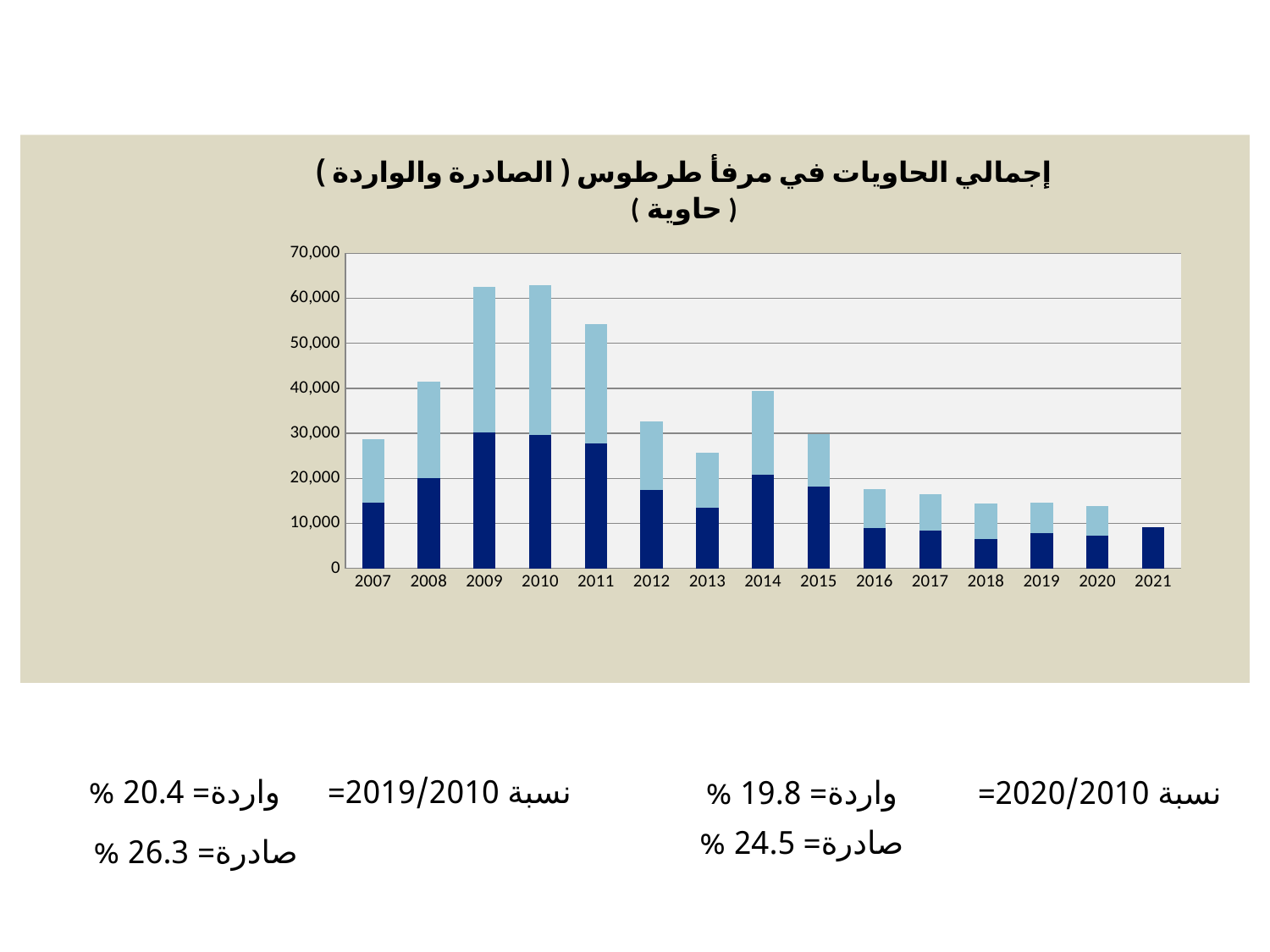
What is the highest value shown on the y axis of the chart? 70,000 How many years are shown on the x axis of the chart? 15 Is the total value for 2008 greater or less than 40,000? greater Is the total value for 2013 greater or less than 20,000? greater Which year has the larger total bar, 2008 or 2015? 2008 Is the total value for 2016 greater or less than 20,000? less What kind of chart is shown on the slide? Stacked bar chart Do the total values rise or fall from 2015 to 2021? fall Which year has the larger total bar, 2011 or 2014? 2011 Which year has the lowest total bar in the chart? 2021